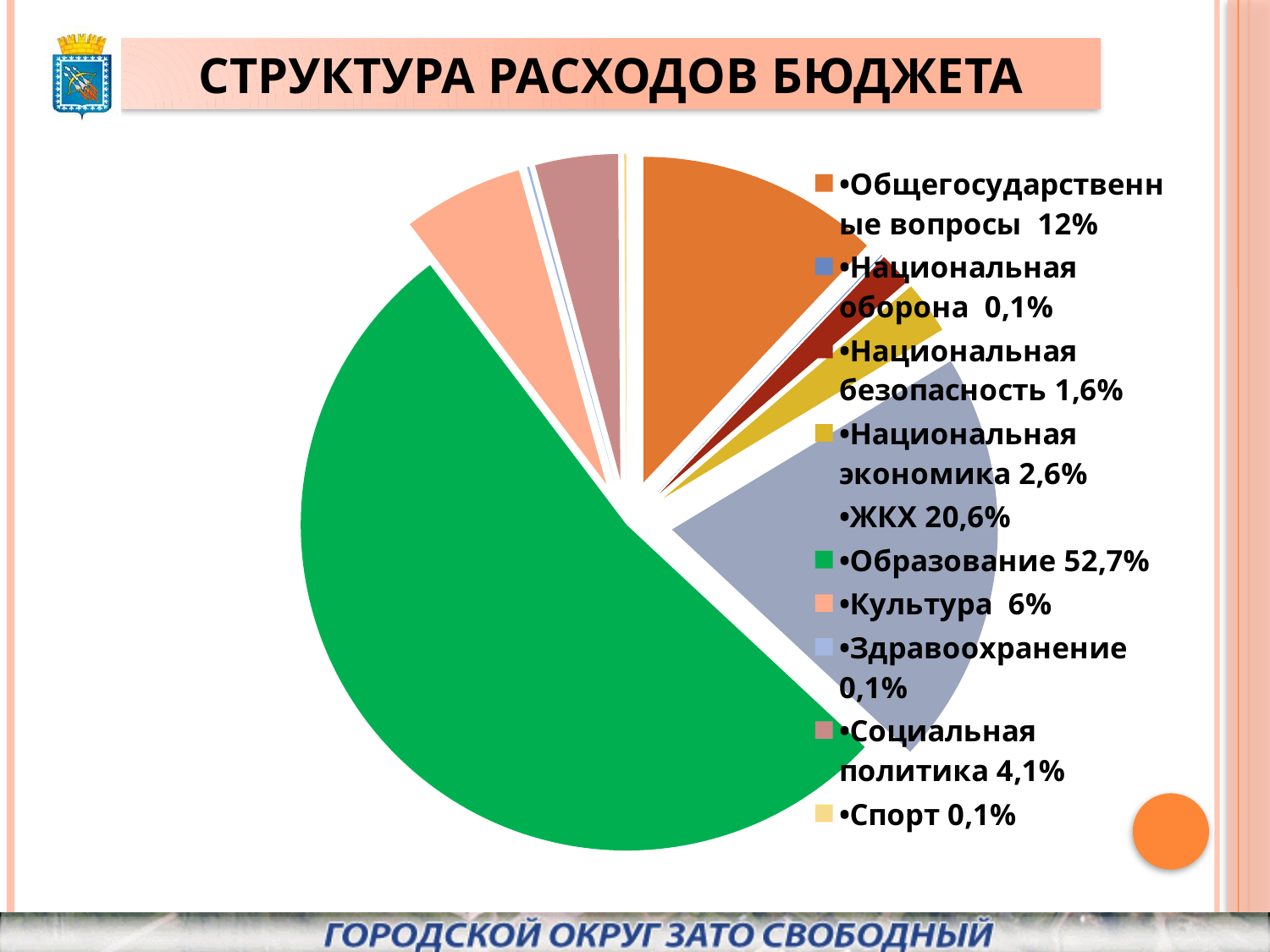
What share of budget expenditure goes to Социальная политика? 4,1% What share of budget expenditure goes to ЖКХ? 20,6% What is the difference between the shares for Общегосударственные вопросы and Культура? 6% What is the title of the chart on the slide? СТРУКТУРА РАСХОДОВ БЮДЖЕТА How many categories does the legend of the pie chart list? 10 What kind of chart is shown on the slide? Pie chart What share of budget expenditure goes to Образование? 52,7% Which is larger, the share for Культура or the share for Национальная экономика? Культура Which category has the largest share of the pie? Образование What share of budget expenditure goes to Общегосударственные вопросы? 12% What colour is the slice for Образование? Green What is the difference between the shares for Образование and ЖКХ? 32,1%